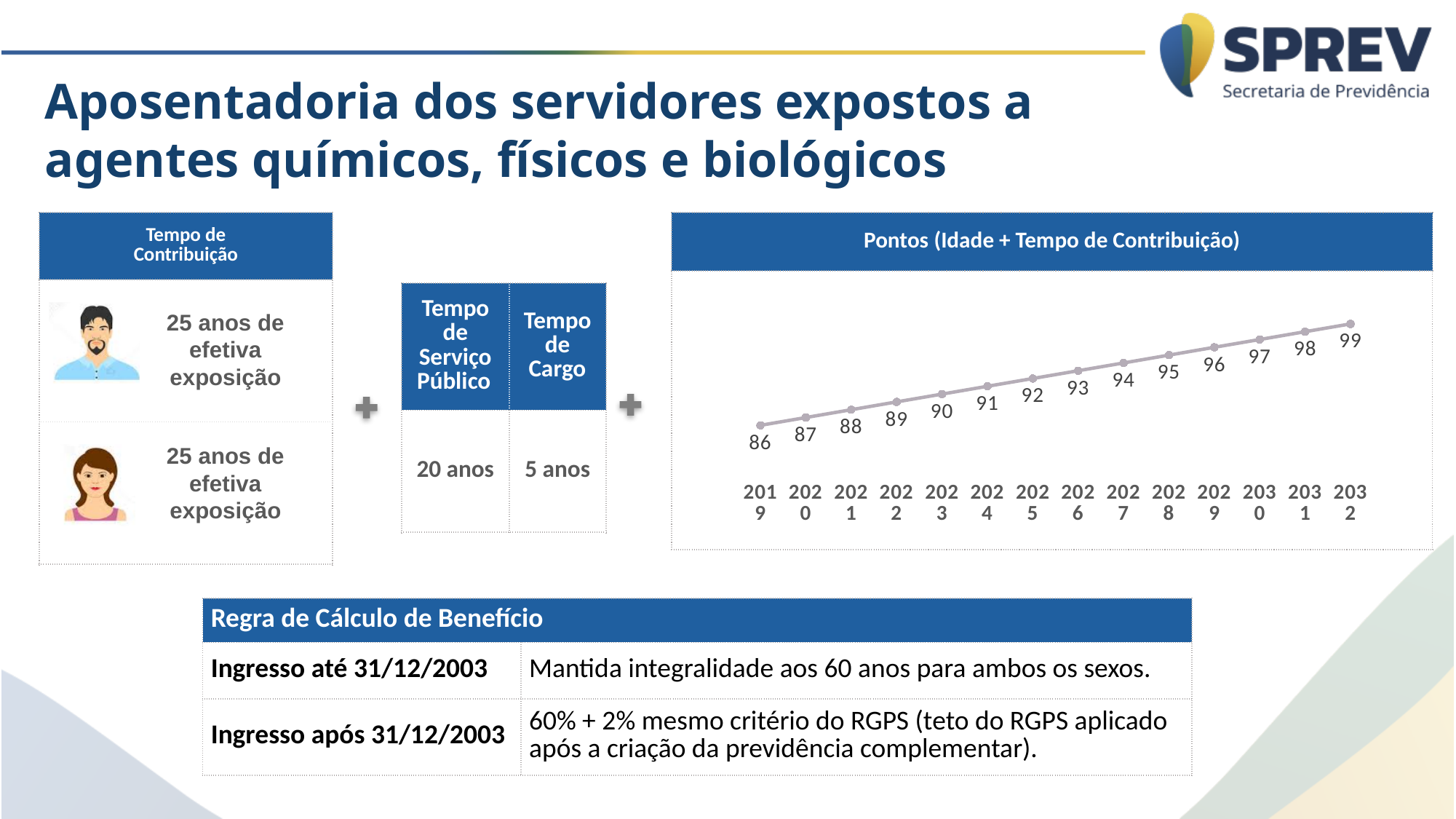
In the "Pontos (Idade + Tempo de Contribuição)" chart, which year has the lowest value? 2019 What is the title of the line chart on the slide? Pontos (Idade + Tempo de Contribuição) In the "Pontos (Idade + Tempo de Contribuição)" chart, what is the value for 2025? 92 In the "Pontos (Idade + Tempo de Contribuição)" chart, what is the value for 2019? 86 In the "Pontos (Idade + Tempo de Contribuição)" chart, do the values rise or fall from 2019 to 2032? rise In the "Pontos (Idade + Tempo de Contribuição)" chart, what is the difference between the values for 2028 and 2022? 6 How many data points are plotted in the "Pontos (Idade + Tempo de Contribuição)" chart? 14 In the "Pontos (Idade + Tempo de Contribuição)" chart, which is larger, the value for 2023 or the value for 2030? 2030 In the "Pontos (Idade + Tempo de Contribuição)" chart, which year has the highest value? 2032 In the "Pontos (Idade + Tempo de Contribuição)" chart, what is the value for 2032? 99 In the "Pontos (Idade + Tempo de Contribuição)" chart, what is the difference between the values for 2032 and 2019? 13 What type of chart is shown under the title "Pontos (Idade + Tempo de Contribuição)"? line chart